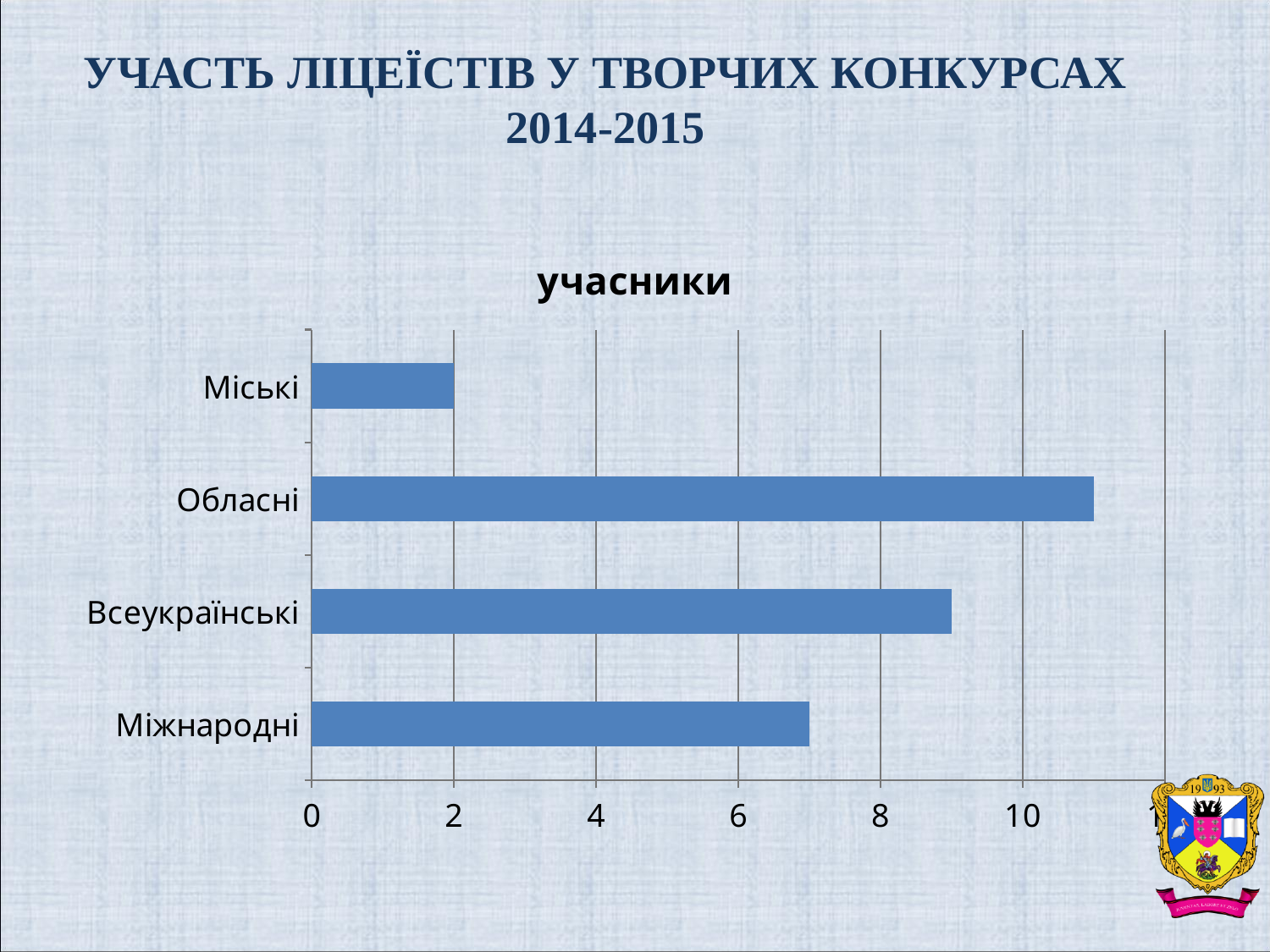
Which category has the lowest value? Міські What is the value for Міські? 2 What colour are the bars in the chart? blue How many categories are plotted in the chart? 4 Is the value for Обласні greater or less than 10? greater Is the value for Всеукраїнські greater or less than 8? greater Is the value for Міжнародні greater or less than 8? less What is the title of the chart? учасники Which is larger, the value for Всеукраїнські or the value for Міжнародні? Всеукраїнські Which is larger, the value for Обласні or the value for Всеукраїнські? Обласні What kind of chart is shown on the slide? bar chart Which category has the highest value? Обласні